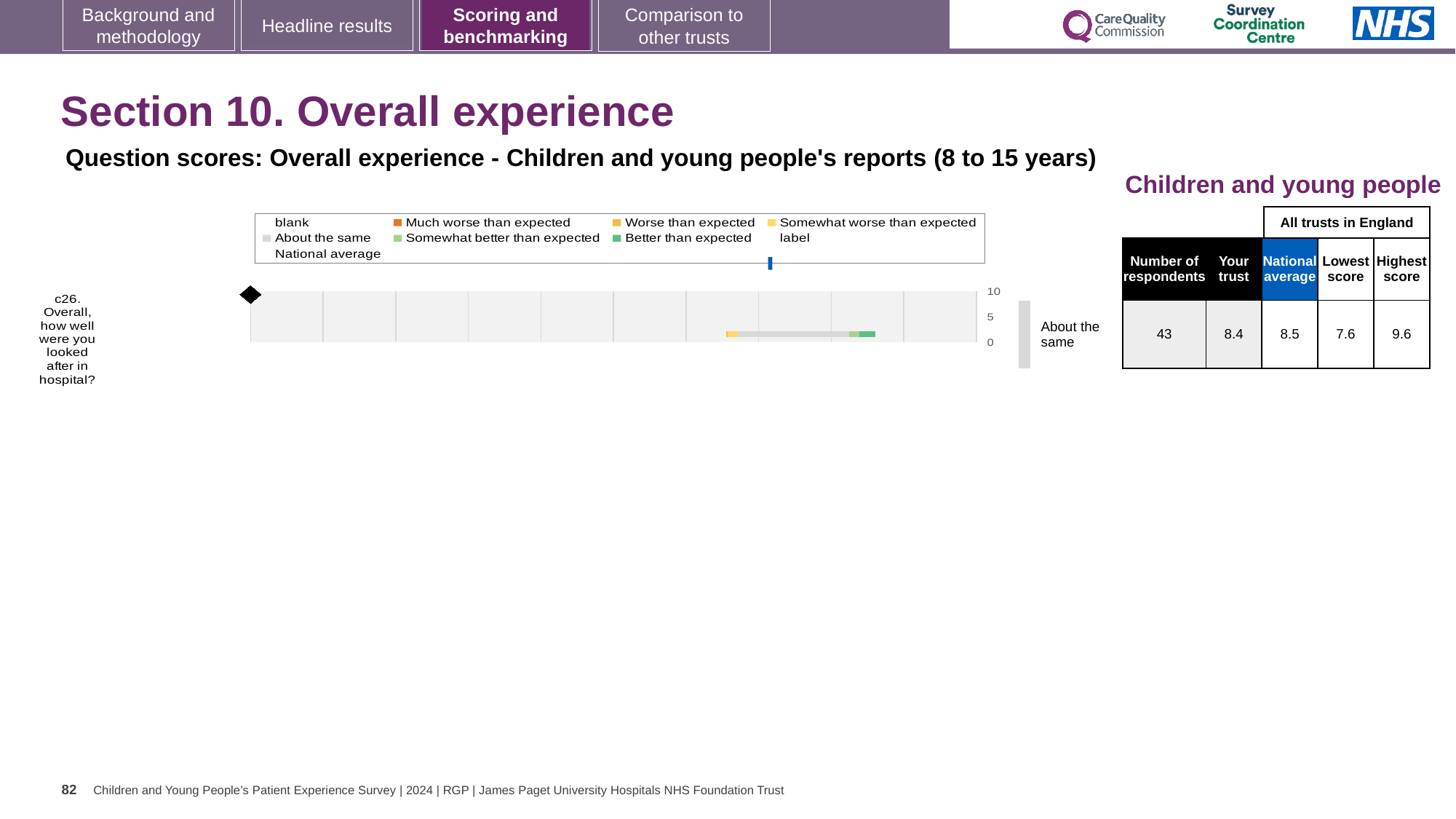
In the table beside the chart, what is the national average score for question c26? 8.5 In the table beside the chart, which is larger for question c26: the 'Your trust' score or the national average? National average In the table beside the chart, what is the lowest score among all trusts in England for question c26? 7.6 In the table beside the chart, what is the difference between the highest score and the lowest score for question c26? 2.0 How many survey questions are plotted in the chart? 1 In the table beside the chart, what is the highest score among all trusts in England for question c26? 9.6 What benchmark category is shown to the right of the bar for question c26? About the same Which legend entry is represented by the blue marker in the chart? National average What kind of chart is shown for question c26? bar chart Which question is plotted in the chart? c26. Overall, how well were you looked after in hospital? In the table beside the chart, what is the 'Your trust' score for question c26? 8.4 In the table beside the chart, how many respondents answered question c26? 43